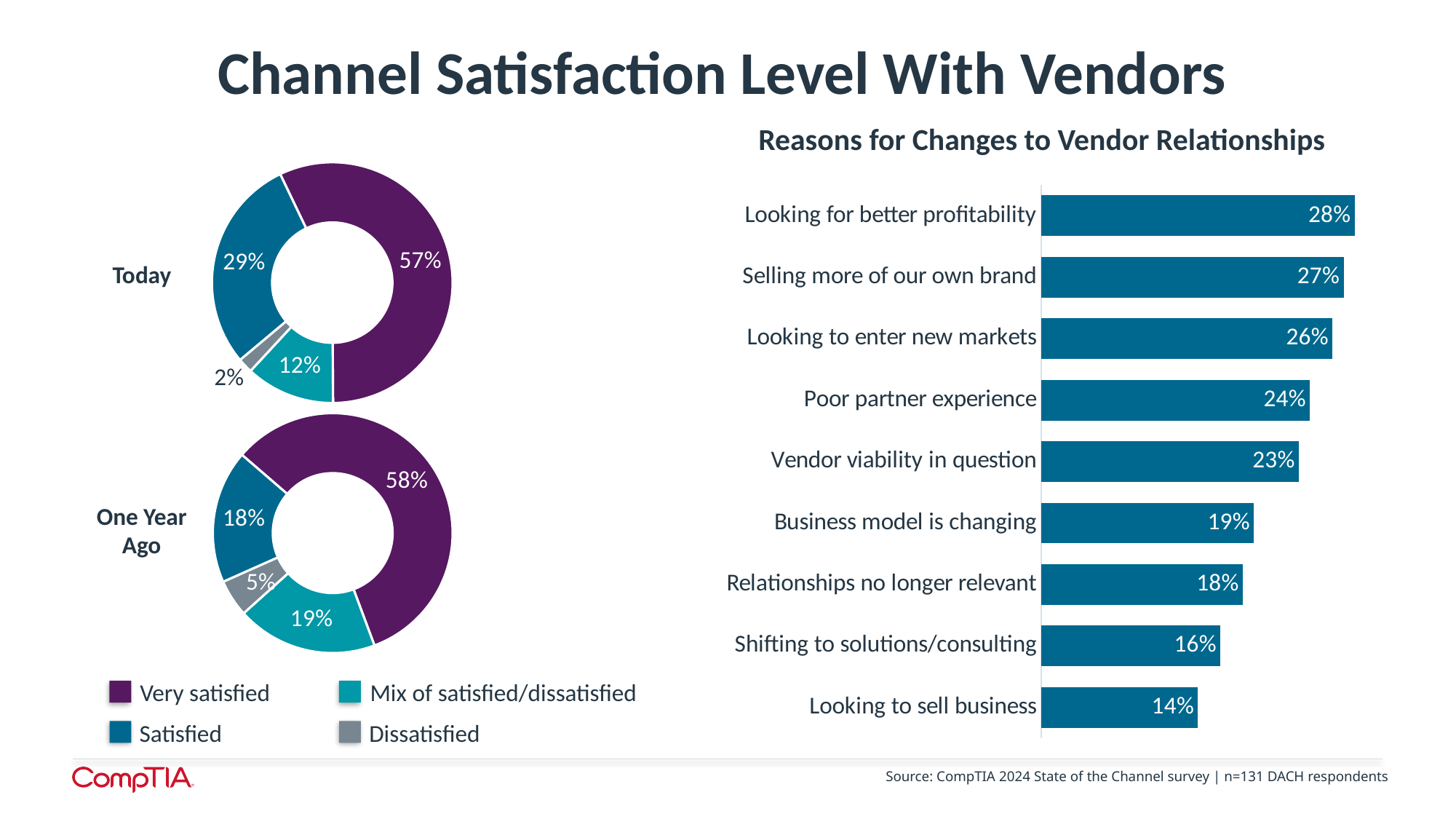
What is the difference between the Satisfied share Today and One Year Ago? 11 percentage points In the 'Today' donut chart, which category has the smallest share? Dissatisfied In the 'Reasons for Changes to Vendor Relationships' chart, which reason has the highest value? Looking for better profitability In the 'Reasons for Changes to Vendor Relationships' chart, which reason has the lowest value? Looking to sell business How many categories does the legend of the donut charts list? 4 In the 'One Year Ago' donut chart, what percentage is Satisfied? 18% In the 'Reasons for Changes to Vendor Relationships' chart, how many reasons are listed? 9 In the 'Today' donut chart, what percentage is Very satisfied? 57% In the 'One Year Ago' donut chart, what percentage is Dissatisfied? 5% What kind of chart is 'Reasons for Changes to Vendor Relationships'? Bar chart In the 'Reasons for Changes to Vendor Relationships' chart, what is the value for Poor partner experience? 24% Is the Mix of satisfied/dissatisfied share larger Today or One Year Ago? One Year Ago